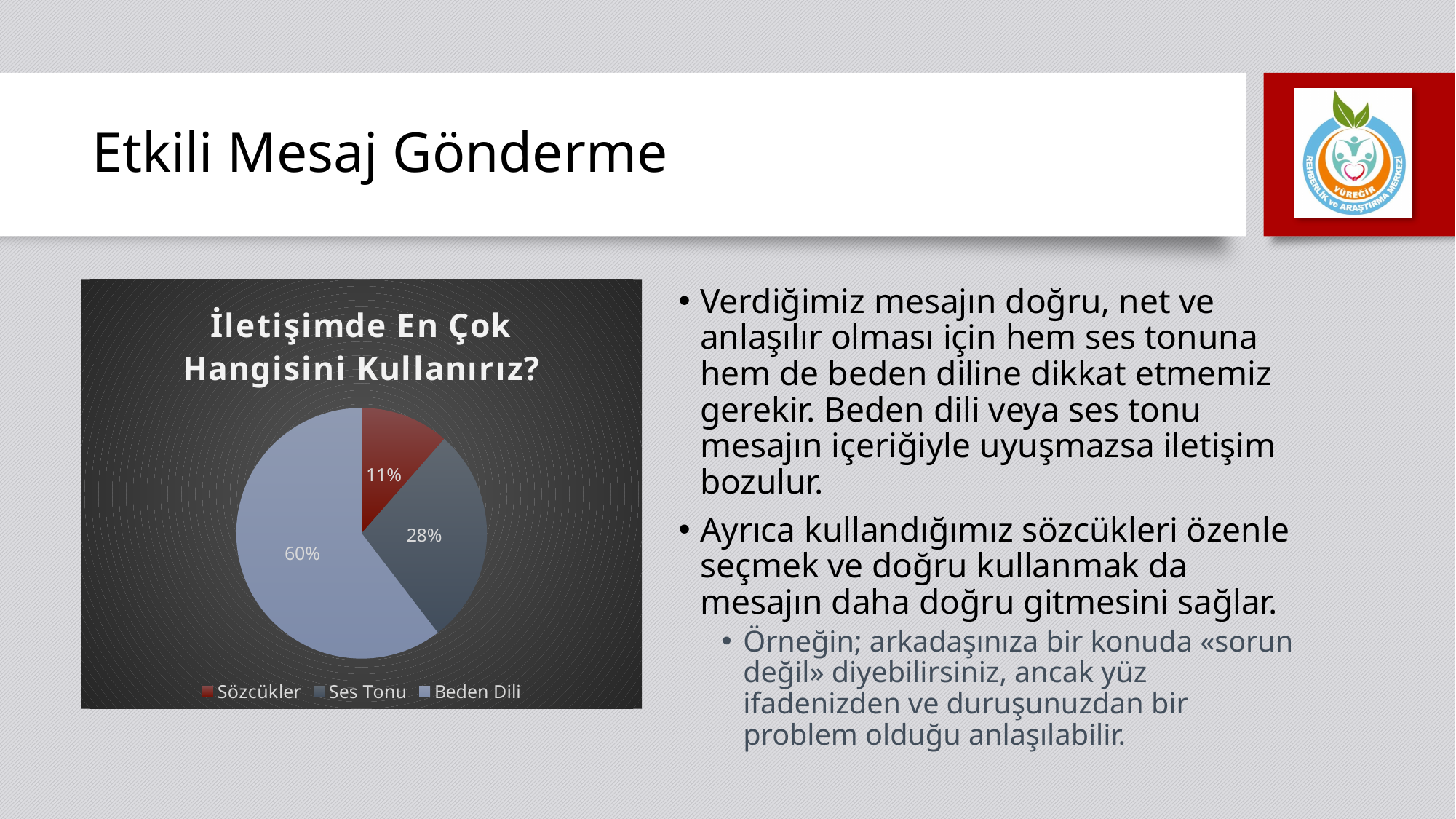
Which legend entry is shown in red? Sözcükler What percentage does the chart show for Sözcükler? 11% What percentage does the chart show for Beden Dili? 60% What percentage does the chart show for Ses Tonu? 28% What is the difference in percentage points between Beden Dili and Ses Tonu? 32 How many categories does the pie chart show? 3 Which is larger, the share for Ses Tonu or the share for Sözcükler? Ses Tonu Which category has the largest share of the pie? Beden Dili What is the difference in percentage points between Ses Tonu and Sözcükler? 17 What kind of chart is shown on the slide? pie chart Which category has the smallest share of the pie? Sözcükler What is the title of the chart? İletişimde En Çok Hangisini Kullanırız?